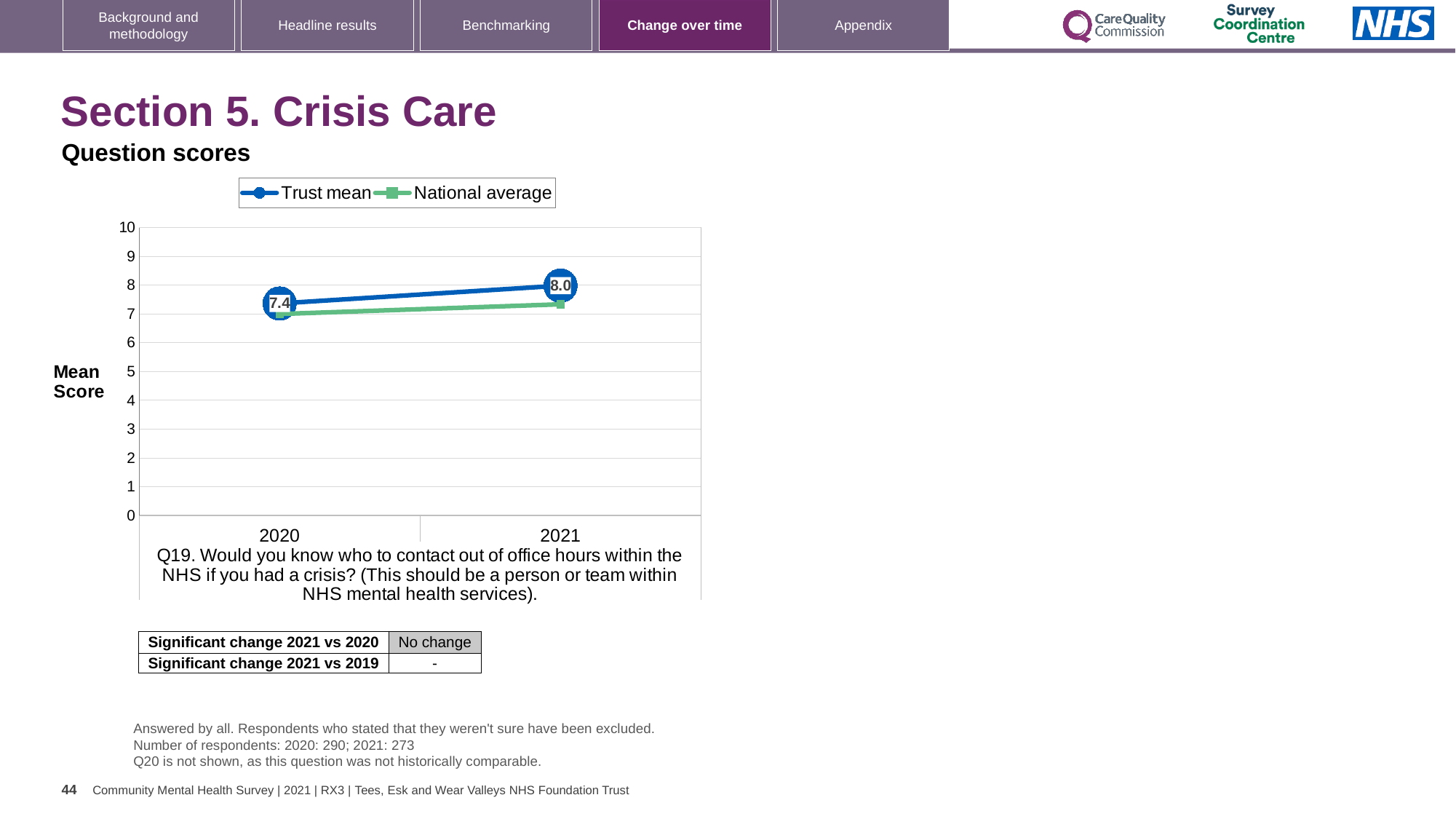
What is the Trust mean score for 2021? 8.0 What is the label on the y axis of the chart? Mean Score By how much did the Trust mean score change from 2020 to 2021? 0.6 Is the National average value for 2020 greater or less than 6? greater In 2021, which is higher, the Trust mean or the National average? Trust mean How many series does the legend list? 2 What kind of chart is shown on the slide? line chart What is the Trust mean score for 2020? 7.4 Is the National average value for 2021 greater or less than 8? less Does the Trust mean score rise or fall from 2020 to 2021? rise How many years are plotted on the x axis? 2 Which year has the higher Trust mean score, 2020 or 2021? 2021